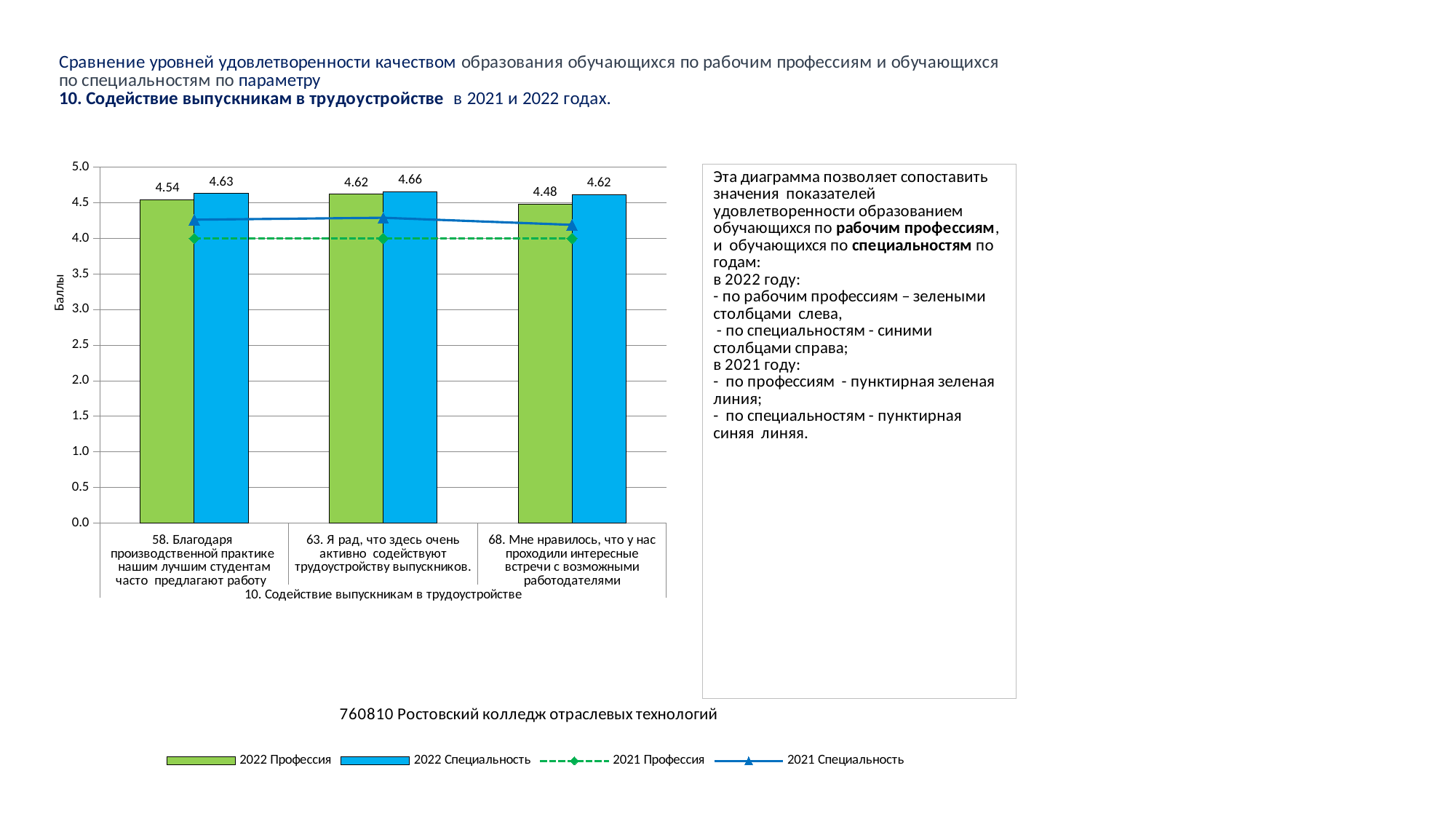
What is the label of the y axis of the chart? Баллы What is the value of the 2022 Профессия bar for category 68 (Мне нравилось, что у нас проходили интересные встречи с возможными работодателями)? 4.48 What is the value of the 2022 Специальность bar for category 63 (Я рад, что здесь очень активно содействуют трудоустройству выпускников)? 4.66 Which category has the highest 2022 Специальность bar? 63. Я рад, что здесь очень активно содействуют трудоустройству выпускников. Which category has the lowest 2022 Профессия bar? 68. Мне нравилось, что у нас проходили интересные встречи с возможными работодателями What type of chart is shown on the slide? Combined bar and line chart How many categories are shown on the x axis of the chart? 3 Is the 2021 Специальность line value for category 58 greater or less than 4.5? less What is the difference between the 2022 Специальность and 2022 Профессия bars for category 68? 0.14 How many series does the chart legend list? 4 What is the value of the 2022 Профессия bar for category 58 (Благодаря производственной практике нашим лучшим студентам часто предлагают работу)? 4.54 For category 58, which is larger: the 2022 Профессия bar or the 2022 Специальность bar? 2022 Специальность